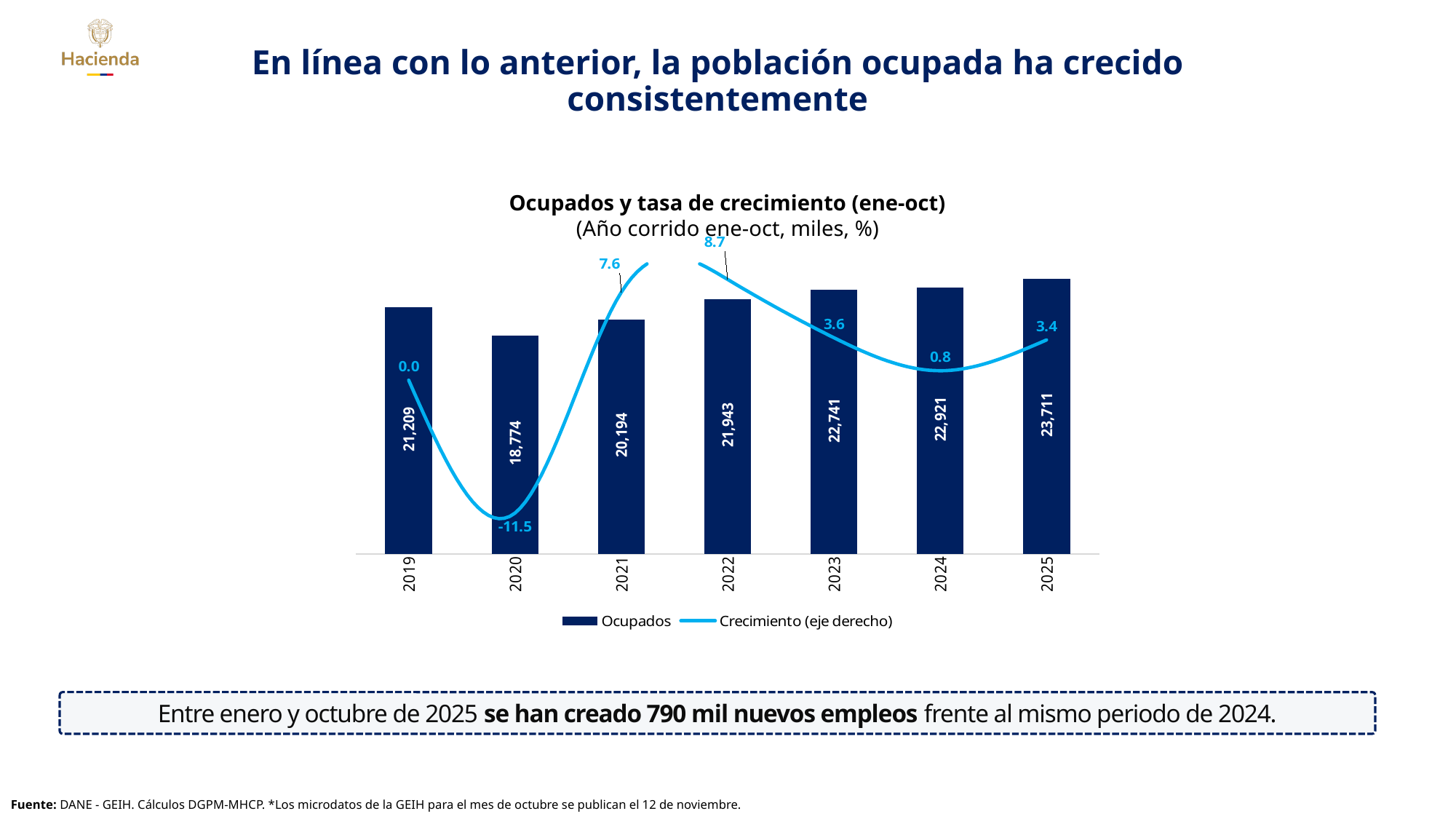
How many series does the legend list? 2 What is the title of the chart? Ocupados y tasa de crecimiento (ene-oct) What is the difference between the Ocupados values for 2025 and 2024? 790 Which year has the highest Ocupados value? 2025 What is the Crecimiento (eje derecho) value for 2022? 8.7 Which year has the lowest Crecimiento (eje derecho) value? 2020 Which is larger, the Ocupados value for 2019 or for 2021? 2019 What is the Crecimiento (eje derecho) value for 2020? -11.5 What is the Ocupados value for 2025? 23,711 Do the Ocupados values rise or fall from 2021 to 2025? rise How many years are shown on the x axis? 7 What is the Ocupados value for 2020? 18,774